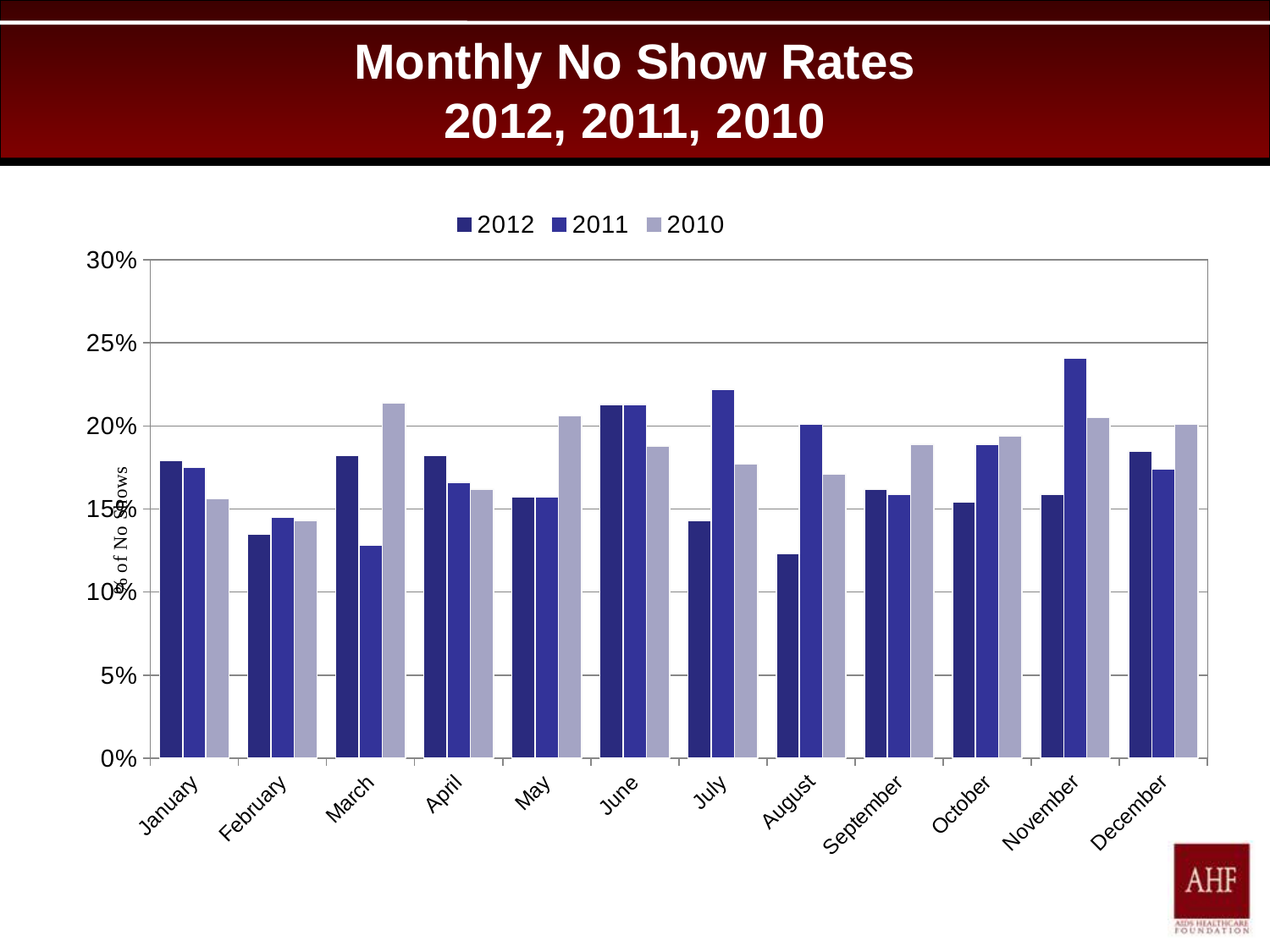
How many series does the legend list? 3 What is the label on the vertical axis? % of No Shows What kind of chart is shown on the slide? bar chart In July, which year has the higher no show rate, 2011 or 2012? 2011 In which month is the 2011 no show rate highest? November How many months are shown along the x axis? 12 In March, which year has the higher no show rate, 2010 or 2011? 2010 Is the 2012 no show rate for August greater or less than 15%? less In which month is the 2011 no show rate lowest? March Is the 2011 no show rate for November greater or less than 20%? greater Is the 2010 no show rate for March greater or less than 20%? greater In which month is the 2012 no show rate lowest? August